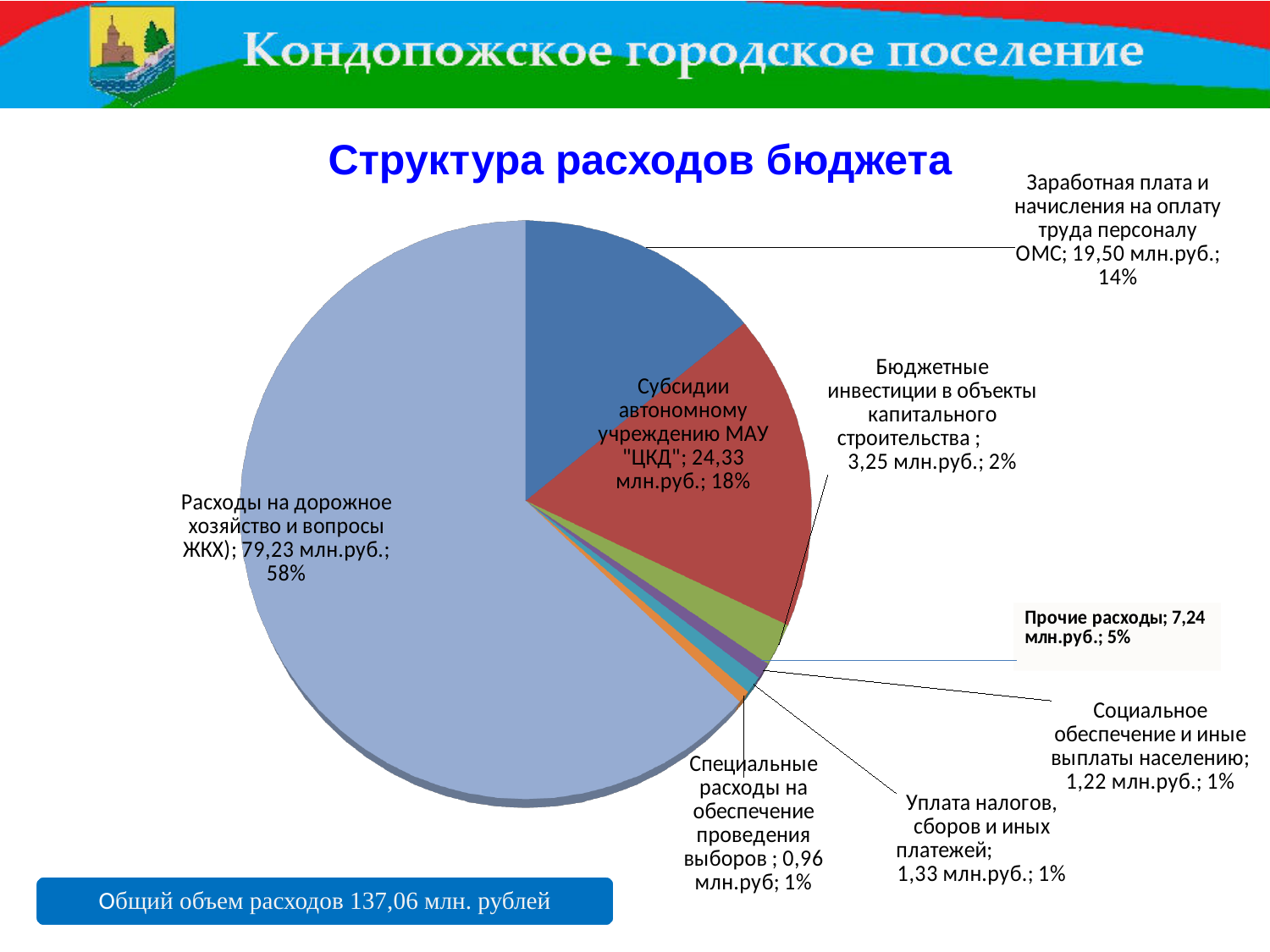
Какова сумма уплаты налогов, сборов и иных платежей на диаграмме? 1,33 млн.руб. Что больше: прочие расходы или бюджетные инвестиции в объекты капитального строительства? Прочие расходы Какой тип диаграммы показан на слайде «Структура расходов бюджета»? круговая диаграмма Какой общий объем расходов указан на слайде? 137,06 млн. рублей На сколько млн.руб. субсидии автономному учреждению МАУ «ЦКД» превышают заработную плату и начисления на оплату труда персоналу ОМС? 4,83 млн.руб. Какова сумма расходов на дорожное хозяйство и вопросы ЖКХ на диаграмме «Структура расходов бюджета»? 79,23 млн.руб. Какая категория расходов имеет наибольшую долю на диаграмме «Структура расходов бюджета»? Расходы на дорожное хозяйство и вопросы ЖКХ Сколько категорий расходов показано на круговой диаграмме «Структура расходов бюджета»? 8 Какую долю расходов составляют бюджетные инвестиции в объекты капитального строительства? 2% Какова сумма заработной платы и начислений на оплату труда персоналу ОМС на диаграмме? 19,50 млн.руб. Какая категория расходов имеет наименьшую сумму на диаграмме «Структура расходов бюджета»? Специальные расходы на обеспечение проведения выборов Какую долю расходов составляют субсидии автономному учреждению МАУ «ЦКД»? 18%